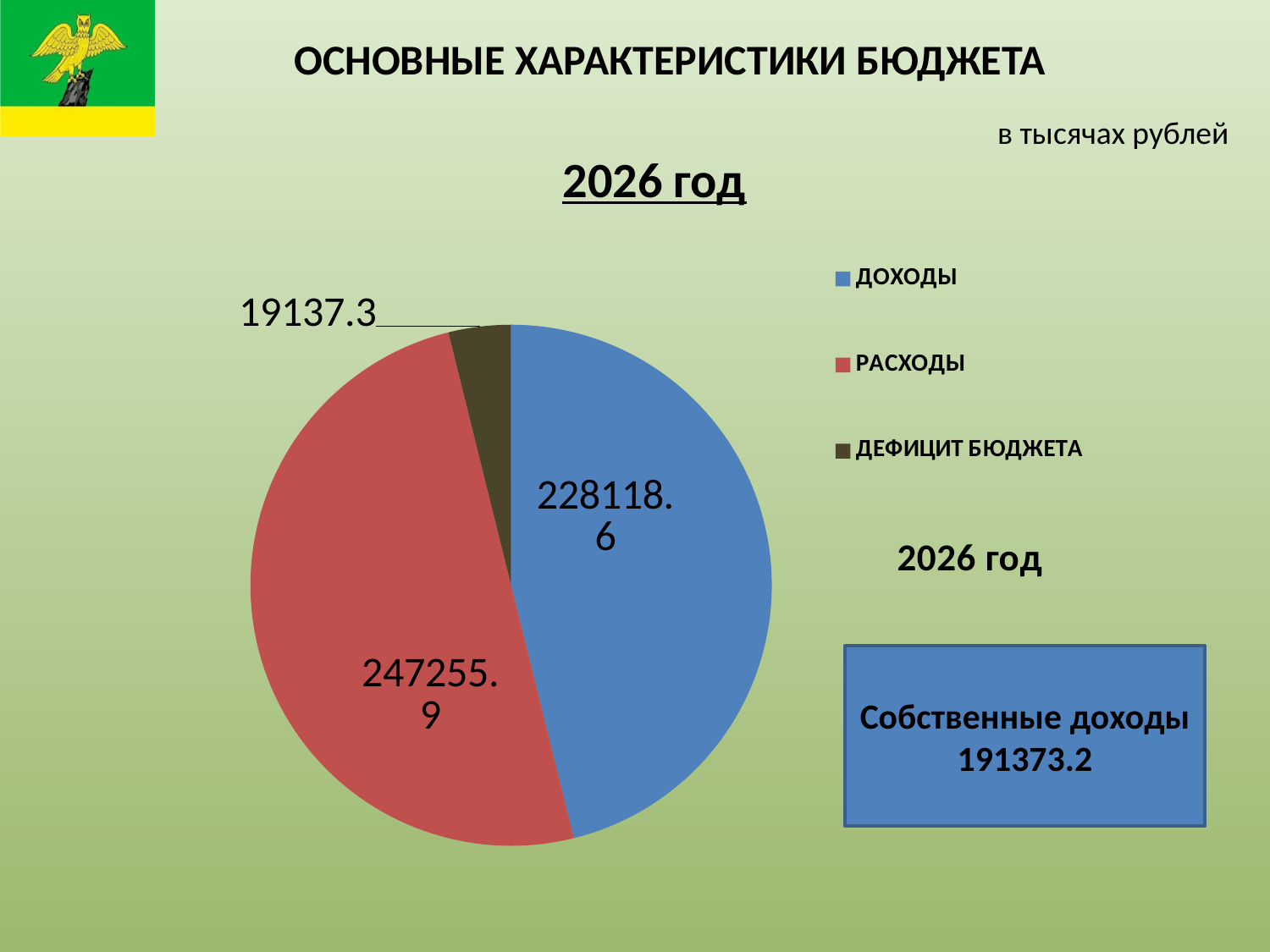
How many entries does the legend of the pie chart list? 3 Which is larger, the value for ДОХОДЫ or the value for РАСХОДЫ? РАСХОДЫ What colour is the ДОХОДЫ slice in the pie chart? blue What type of chart is shown on the slide? pie chart What is the difference between the values for РАСХОДЫ and ДОХОДЫ? 19137.3 What is the value for ДЕФИЦИТ БЮДЖЕТА in the pie chart? 19137.3 What is the value for РАСХОДЫ in the pie chart? 247255.9 How many slices does the pie chart have? 3 Which category has the largest slice in the pie chart? РАСХОДЫ Which category has the smallest slice in the pie chart? ДЕФИЦИТ БЮДЖЕТА What is the total of all three values shown in the pie chart? 494511.8 What is the value for ДОХОДЫ in the pie chart? 228118.6